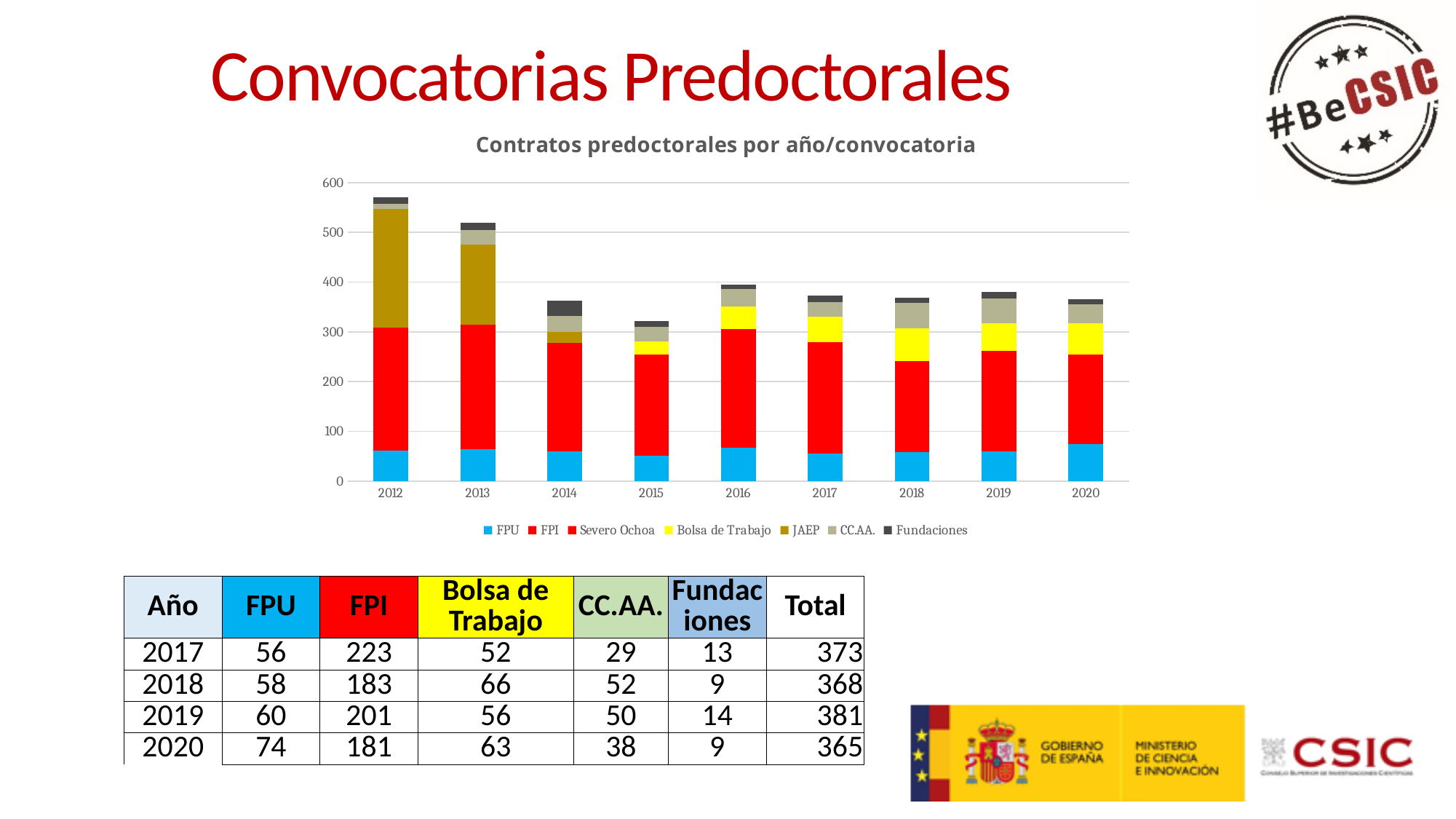
What is the title of the chart? Contratos predoctorales por año/convocatoria How many series does the chart legend list? 7 Which year has the shortest stacked bar in the chart? 2015 Do the total bar heights rise or fall from 2012 to 2015? fall What kind of chart is shown on the slide? Stacked bar chart How many years are shown on the x axis of the chart? 9 Is the total height of the 2015 bar greater or less than 400? less Is the total height of the 2012 bar greater or less than 500? greater According to the table, what is the FPU value for 2020? 74 According to the table, which year has the larger Total, 2017 or 2018? 2017 According to the table, what is the difference between the Total for 2019 and the Total for 2018? 13 Which year has the tallest stacked bar in the chart? 2012